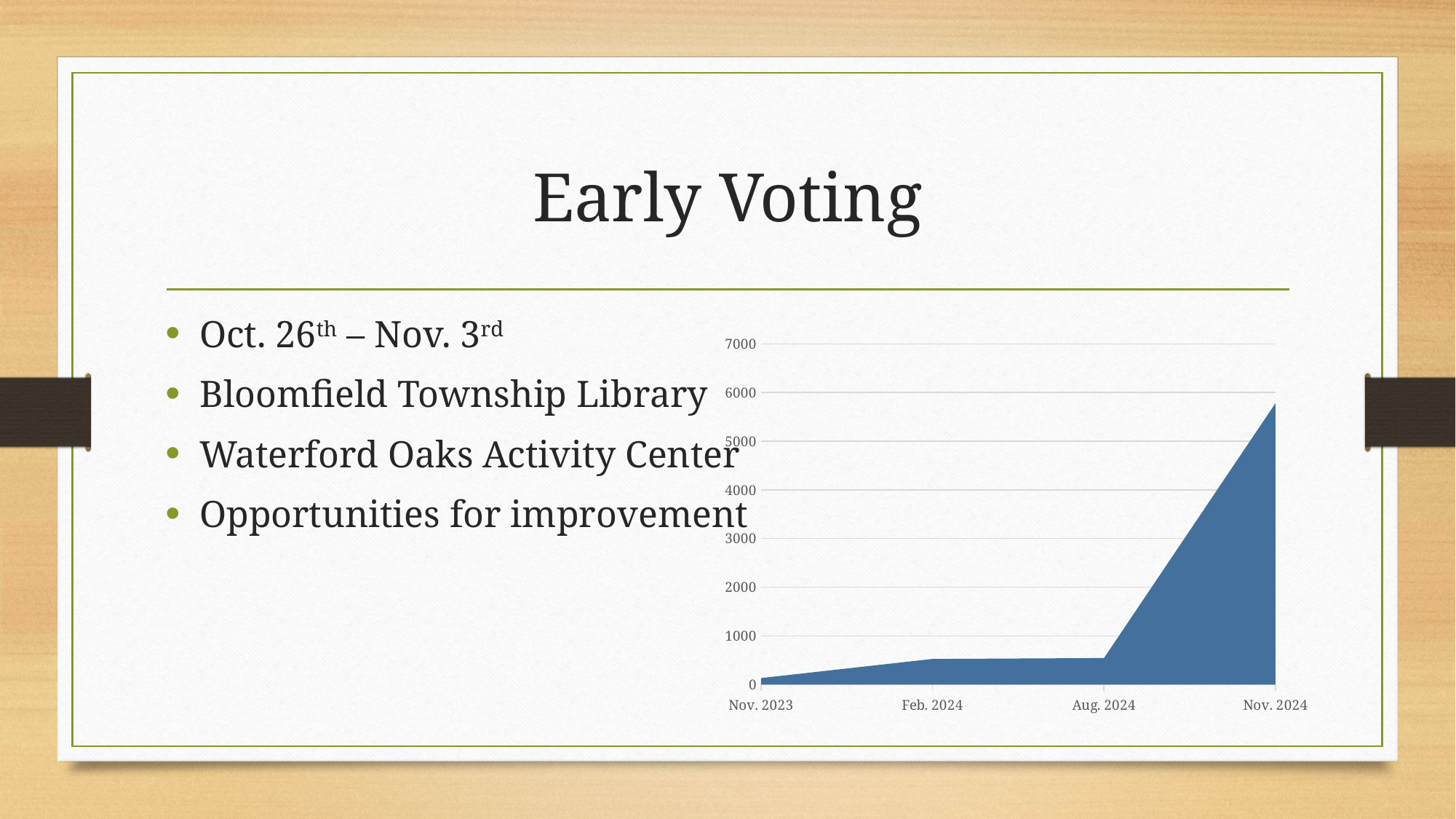
Is the value for Nov. 2024 greater or less than 5000? greater Which time point has the lowest value in the chart? Nov. 2023 Is the value for Nov. 2023 greater or less than 1000? less What is the highest value shown on the chart's y axis? 7000 Which is larger, the value for Nov. 2024 or the value for Aug. 2024? Nov. 2024 Is the value for Aug. 2024 greater or less than 1000? less What kind of chart is shown on the slide? area chart Which time point has the highest value in the chart? Nov. 2024 Between Aug. 2024 and Nov. 2024, does the value rise or fall? rise How many time points are plotted on the x axis of the chart? 4